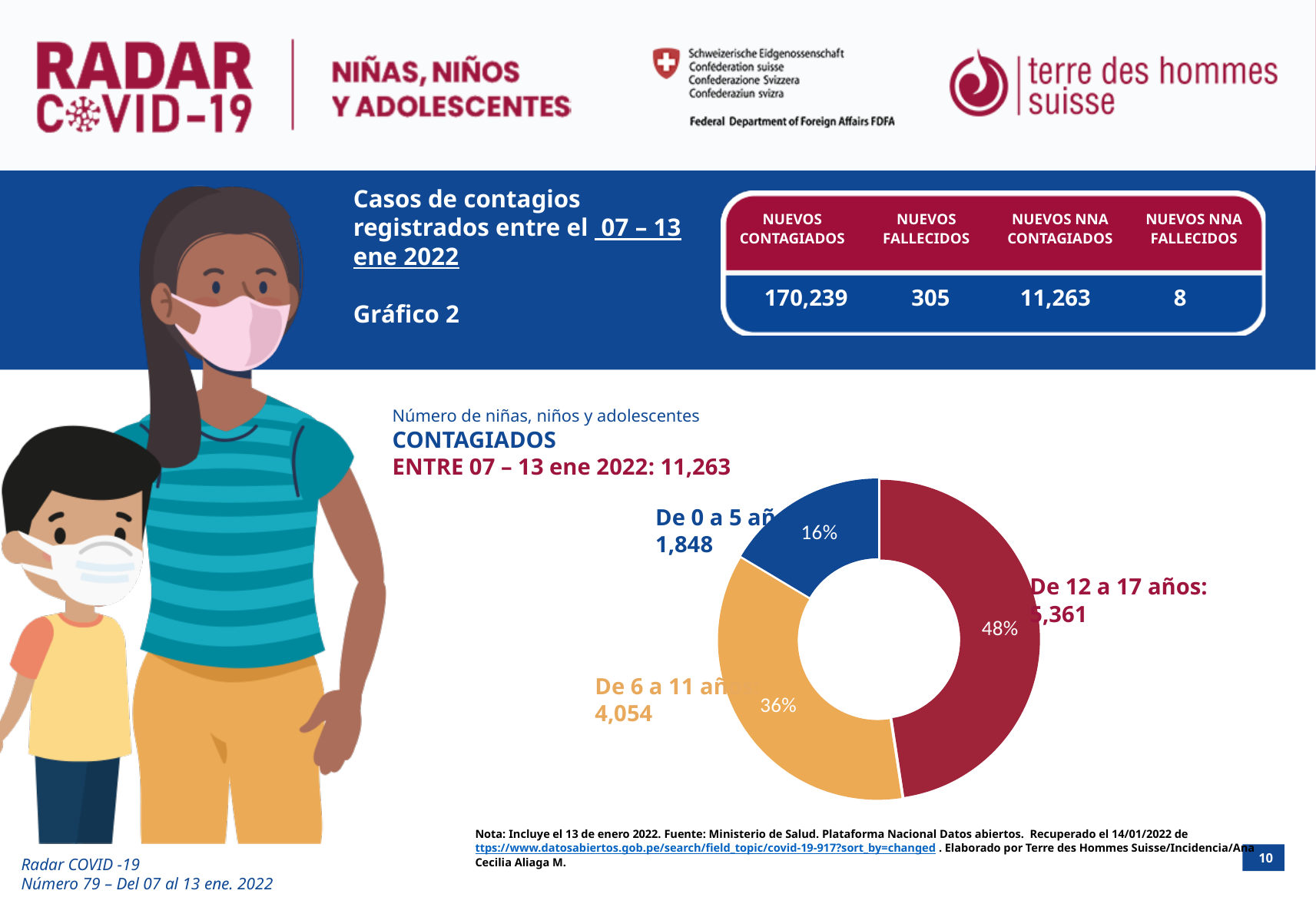
Which age group has the largest share of the donut chart? De 12 a 17 años How many contagiados are shown for the 'De 0 a 5 años' group? 1,848 What percentage of the donut chart corresponds to 'De 6 a 11 años'? 36% What is the total number of niñas, niños y adolescentes contagiados shown in the chart title for 07 – 13 ene 2022? 11,263 How many contagiados are shown for the 'De 6 a 11 años' group? 4,054 Which age group has the smallest share of the donut chart? De 0 a 5 años What percentage of the donut chart corresponds to 'De 12 a 17 años'? 48% How many age groups does the donut chart show? 3 What kind of chart is shown on the slide? Donut (pie) chart What is the difference in contagiados between the 'De 6 a 11 años' and 'De 0 a 5 años' groups? 2,206 What percentage of the donut chart corresponds to 'De 0 a 5 años'? 16% Which group has more contagiados, 'De 6 a 11 años' or 'De 0 a 5 años'? De 6 a 11 años